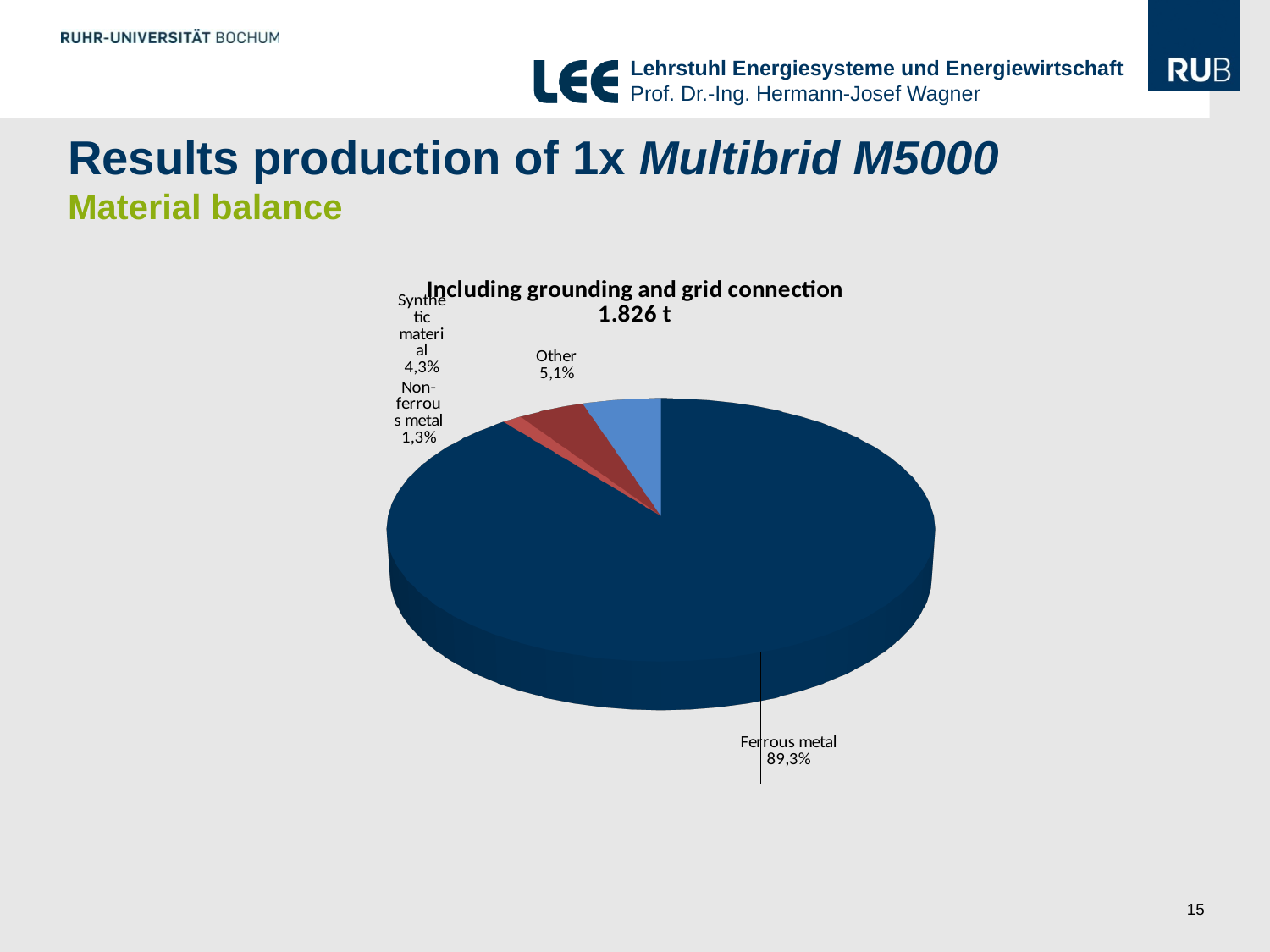
What is the difference in percentage points between Ferrous metal and Other? 84,2% What share of the pie does Non-ferrous metal account for? 1,3% Which category has the smallest slice of the pie? Non-ferrous metal What kind of chart is shown on the slide? Pie chart What share of the pie does Other account for? 5,1% How many categories are shown in the pie chart? 4 What total mass is stated in the chart title? 1.826 t What share of the pie does Ferrous metal account for? 89,3% Which category has the largest slice of the pie? Ferrous metal What is the difference in percentage points between Synthetic material and Non-ferrous metal? 3,0% Which slice is larger, Other or Synthetic material? Other